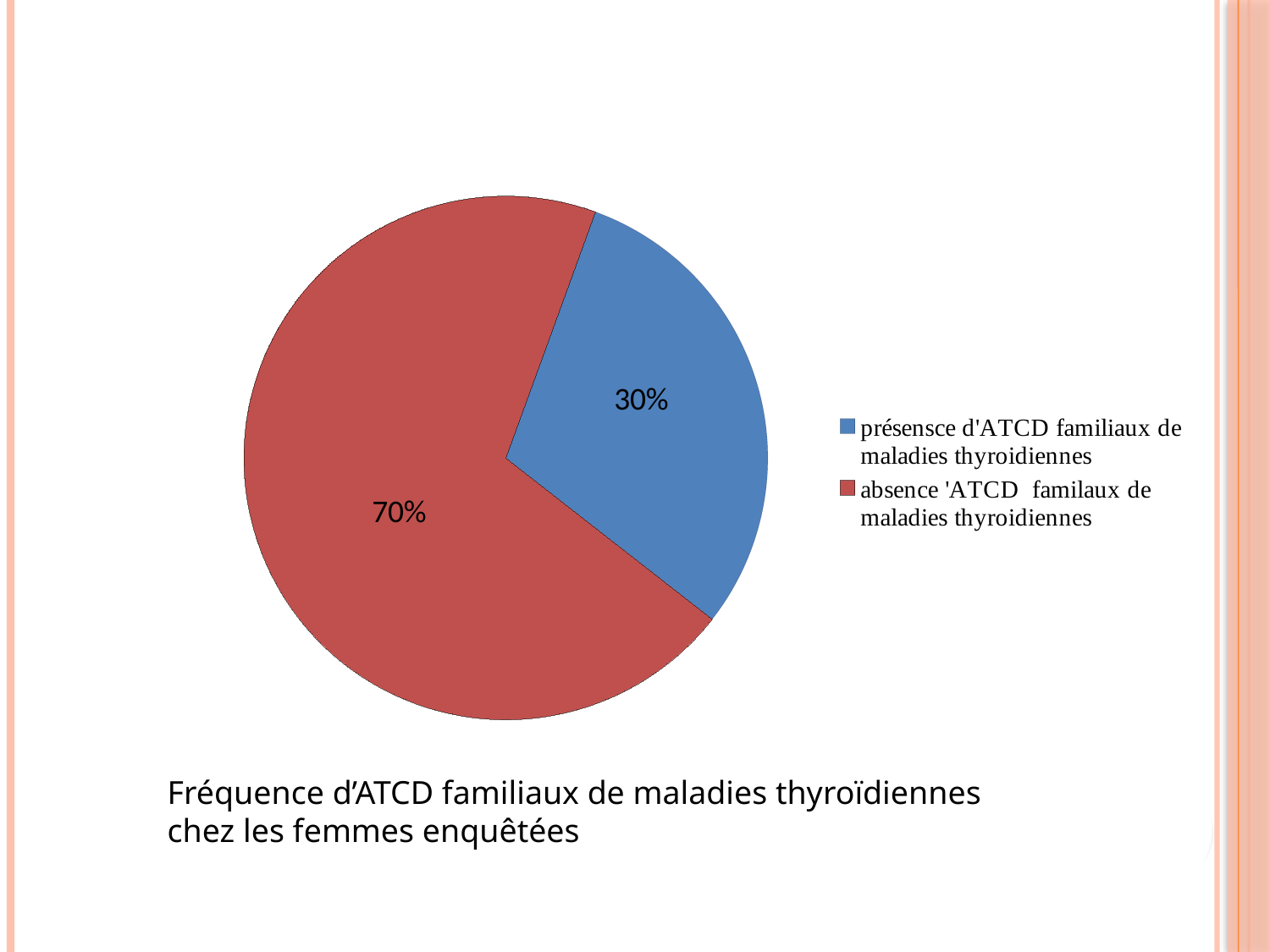
How many entries does the legend list? 2 What kind of chart is shown on the slide? pie chart What share of the pie is labelled "absence 'ATCD familaux de maladies thyroidiennes"? 70% What colour is the slice representing absence d'ATCD familiaux de maladies thyroidiennes? red What is the caption text below the chart? Fréquence d'ATCD familiaux de maladies thyroïdiennes chez les femmes enquêtées How many slices does the pie chart have? 2 What is the difference in percentage points between the absence slice and the présence slice? 40 Which slice of the pie is the smallest? présensce d'ATCD familiaux de maladies thyroidiennes Which is larger: the slice for présence d'ATCD familiaux or the slice for absence d'ATCD familiaux? absence 'ATCD familaux de maladies thyroidiennes Which slice of the pie is the largest? absence 'ATCD familaux de maladies thyroidiennes Is the share for présence d'ATCD familiaux greater or less than 50%? less What share of the pie is labelled "présensce d'ATCD familiaux de maladies thyroidiennes"? 30%